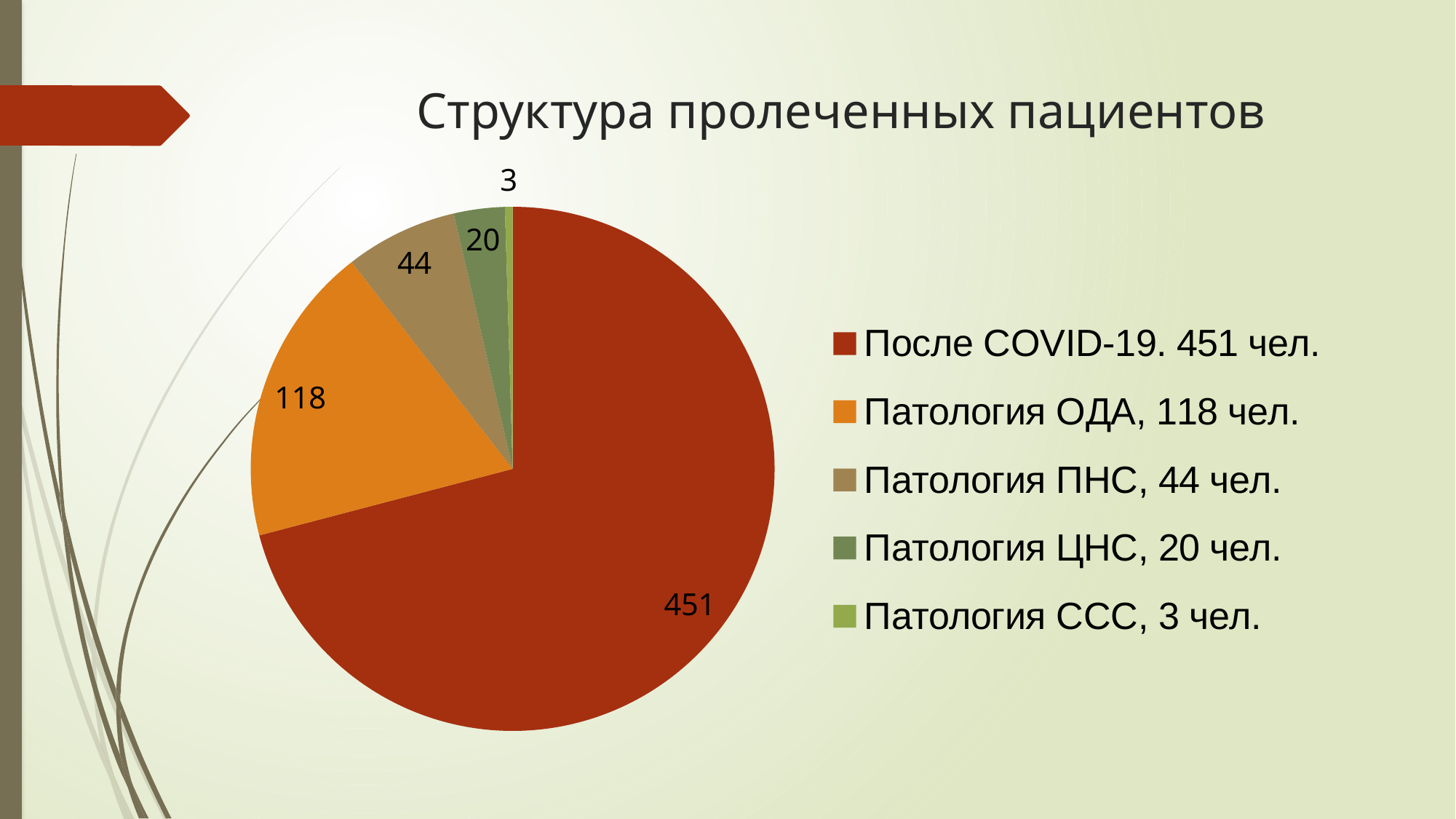
What is the value for Патология ОДА? 118 Which is larger, the value for Патология ПНС or the value for Патология ЦНС? Патология ПНС Which category has the smallest slice of the pie? Патология ССС What is the value for Патология ЦНС? 20 What is the value for Патология ПНС? 44 What is the title of the chart? Структура пролеченных пациентов What kind of chart is shown on the slide? Pie chart What is the value for Патология ССС? 3 What is the total of all the values shown in the pie chart? 636 How many slices does the pie chart have? 5 What is the difference between the values for После COVID-19 and Патология ОДА? 333 Which category has the largest slice of the pie? После COVID-19